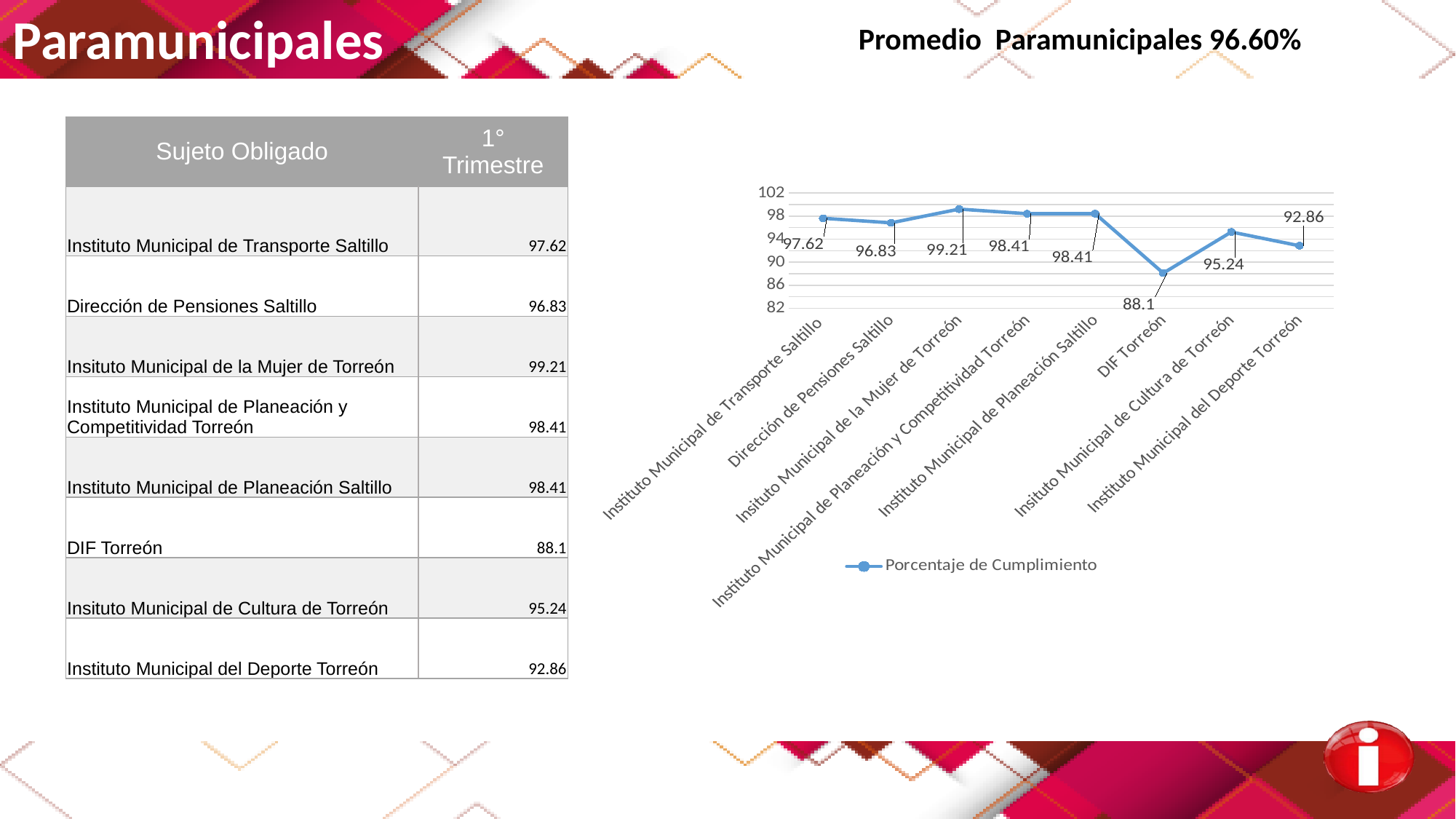
What is the value for DIF Torreón in the chart? 88.1 What is the name of the series shown in the chart legend? Porcentaje de Cumplimiento Which is larger, the value for Dirección de Pensiones Saltillo or the value for Insituto Municipal de Cultura de Torreón? Dirección de Pensiones Saltillo What is the value for Instituto Municipal del Deporte Torreón in the chart? 92.86 What kind of chart is shown on the slide? line chart Which category has the lowest value in the chart? DIF Torreón How many series does the chart legend list? 1 Which category has the highest value in the chart? Insituto Municipal de la Mujer de Torreón Is the value for DIF Torreón greater or less than 90? less How many categories are plotted in the chart? 8 What is the value for Instituto Municipal de Transporte Saltillo in the chart? 97.62 What is the difference between the values for Insituto Municipal de la Mujer de Torreón and DIF Torreón? 11.11